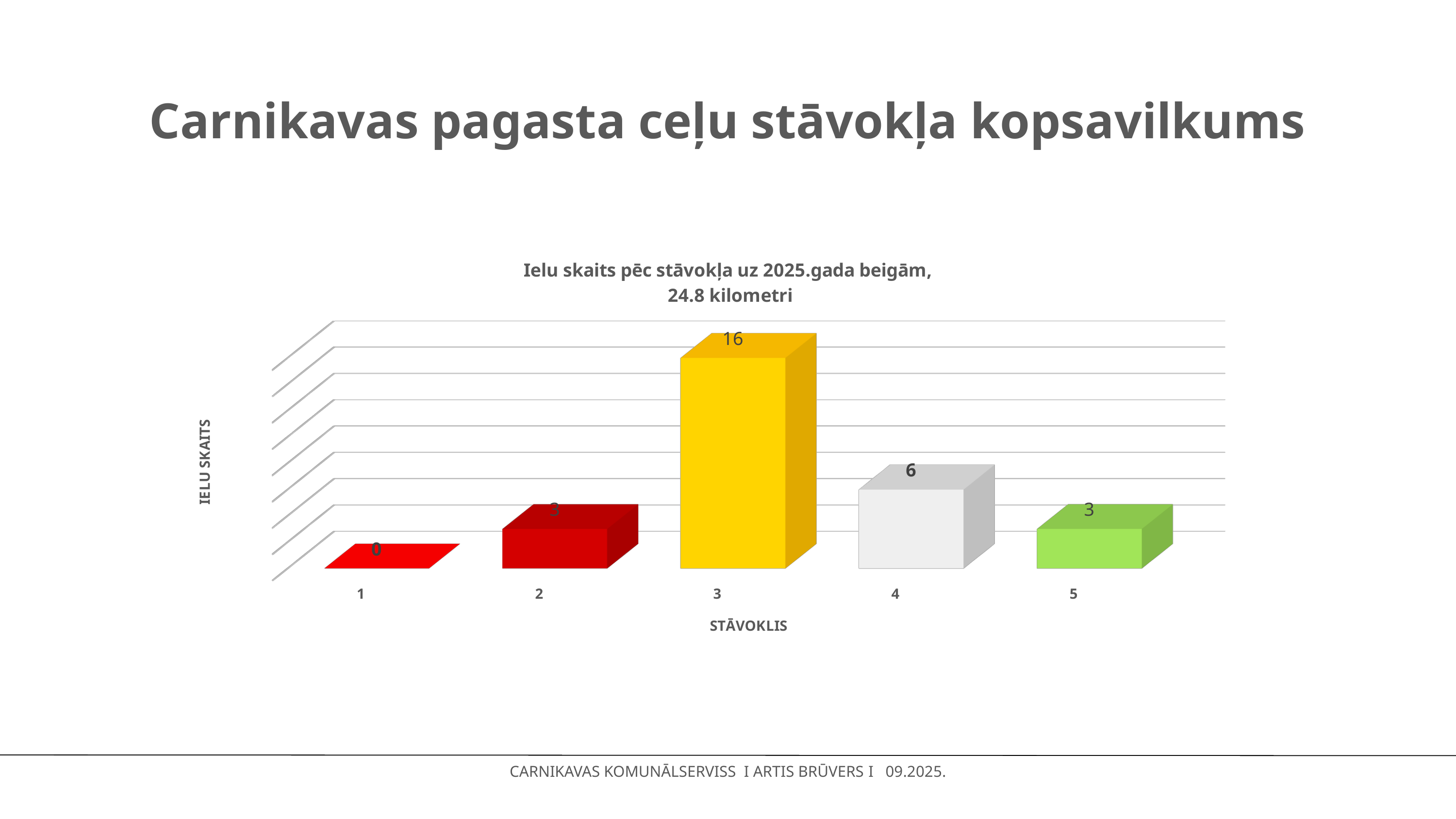
What is the difference between the values for category 4 and category 2? 3 What is the value for category 3 (stāvoklis 3)? 16 How many categories are shown on the x axis? 5 Which is larger, the value for category 4 or the value for category 5? category 4 What is the value for category 1 (stāvoklis 1)? 0 Which category has the highest value? 3 What is the difference between the values for category 3 and category 4? 10 Which category has the lowest value? 1 What is the value for category 4 (stāvoklis 4)? 6 What is the label of the x axis? STĀVOKLIS What is the value for category 5 (stāvoklis 5)? 3 What kind of chart is shown on the slide? bar chart